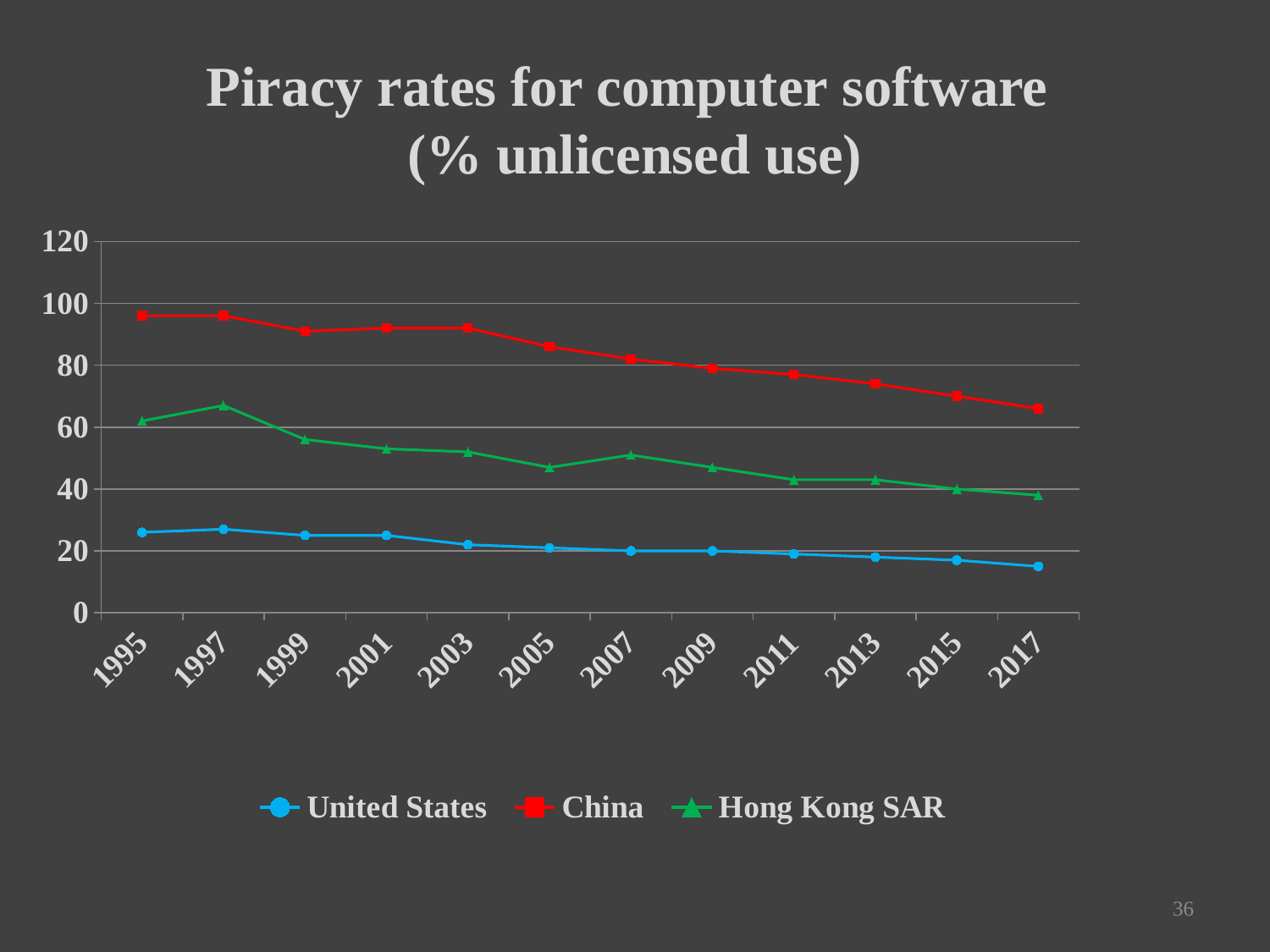
Which series has the highest piracy rate in every year shown? China How many years are plotted along the x axis? 12 Which series has the lowest piracy rate in every year shown? United States In 2017, which is larger: the value for China or the value for Hong Kong SAR? China Is the value for the United States in 2017 greater or less than 20? less Do the piracy rates for China rise or fall from 1995 to 2017? fall What kind of chart is shown on the slide? line chart How many series does the legend list? 3 What is the title of the chart? Piracy rates for computer software (% unlicensed use) Is the value for Hong Kong SAR in 2005 greater or less than 60? less Is the value for China in 1995 greater or less than 80? greater